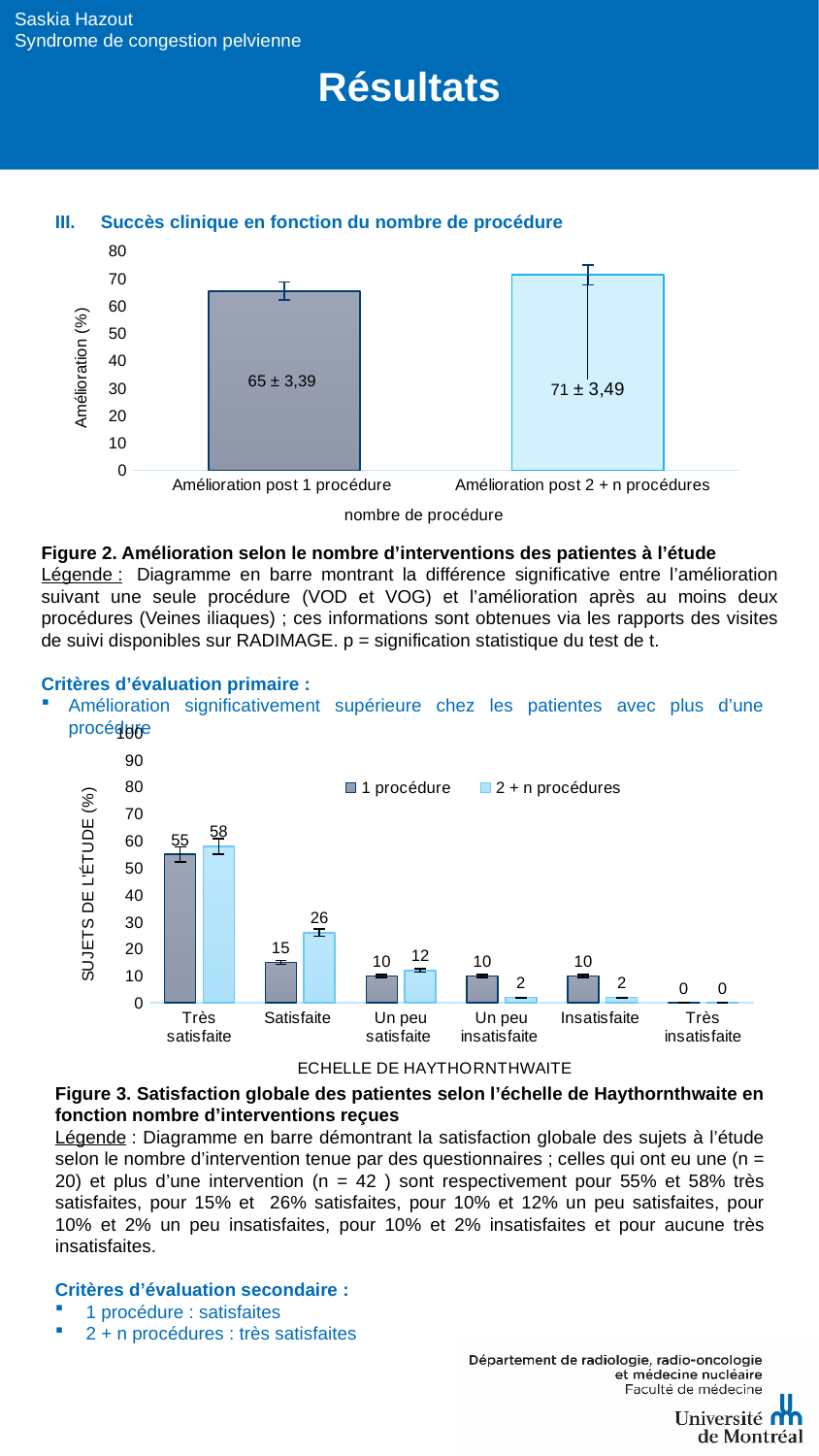
In the bottom chart (Echelle de Haythornthwaite), what is the difference between the '2 + n procédures' and '1 procédure' values for 'Satisfaite'? 11 In the top chart (Succès clinique en fonction du nombre de procédure), what is the value labelled on the bar for 'Amélioration post 2 + n procédures'? 71 ± 3,49 In the bottom chart (Echelle de Haythornthwaite), what is the value for 'Un peu insatisfaite' in the '1 procédure' series? 10 In the top chart (Succès clinique en fonction du nombre de procédure), which bar is higher: 'Amélioration post 1 procédure' or 'Amélioration post 2 + n procédures'? Amélioration post 2 + n procédures In the top chart (Succès clinique en fonction du nombre de procédure), what is the value labelled on the bar for 'Amélioration post 1 procédure'? 65 ± 3,39 In the bottom chart (Echelle de Haythornthwaite), what is the value for 'Satisfaite' in the '2 + n procédures' series? 26 In the bottom chart (Echelle de Haythornthwaite), how many categories are shown on the x axis? 6 In the top chart (Succès clinique en fonction du nombre de procédure), what is the label of the y axis? Amélioration (%) In the bottom chart (Echelle de Haythornthwaite), which category has the highest value in the '2 + n procédures' series? Très satisfaite In the top chart (Succès clinique en fonction du nombre de procédure), how many bars are plotted? 2 In the bottom chart (Echelle de Haythornthwaite), how many series does the legend list? 2 What kind of chart is the bottom chart (Echelle de Haythornthwaite)? Bar chart